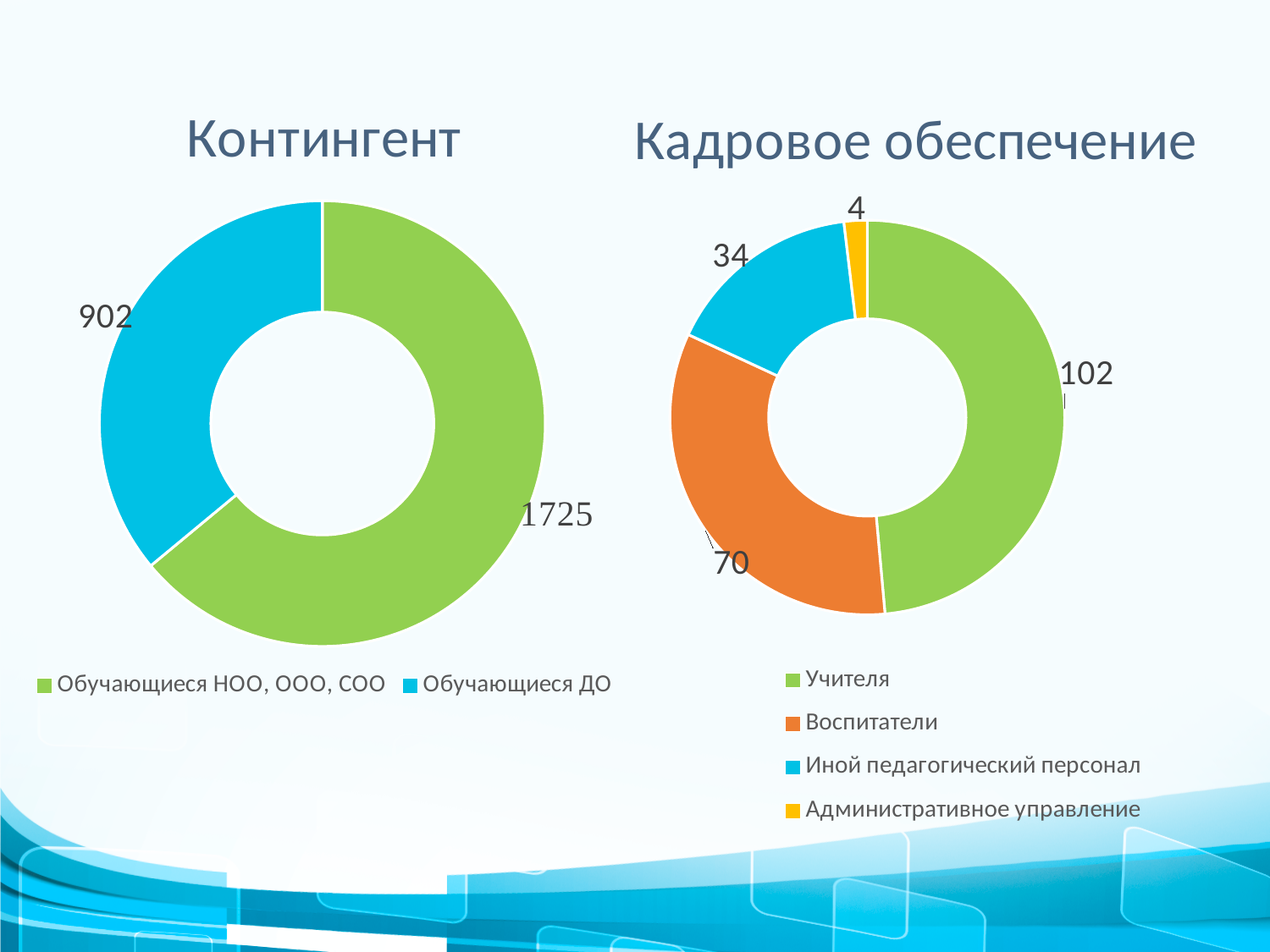
In the 'Контингент' chart, what is the value for 'Обучающиеся НОО, ООО, СОО'? 1725 In the 'Кадровое обеспечение' chart, what colour represents 'Административное управление'? Yellow In the 'Контингент' chart, what is the value for 'Обучающиеся ДО'? 902 In the 'Контингент' chart, what is the difference between 'Обучающиеся НОО, ООО, СОО' and 'Обучающиеся ДО'? 823 What type of chart is the 'Контингент' chart? Doughnut chart In the 'Кадровое обеспечение' chart, which category has the lowest value? Административное управление In the 'Кадровое обеспечение' chart, what is the value for 'Иной педагогический персонал'? 34 In the 'Кадровое обеспечение' chart, which category has the highest value? Учителя How many categories does the 'Кадровое обеспечение' chart show? 4 In the 'Кадровое обеспечение' chart, what is the value for 'Воспитатели'? 70 In the 'Кадровое обеспечение' chart, what is the difference between 'Учителя' and 'Воспитатели'? 32 In the 'Контингент' chart, which category is larger: 'Обучающиеся НОО, ООО, СОО' or 'Обучающиеся ДО'? Обучающиеся НОО, ООО, СОО